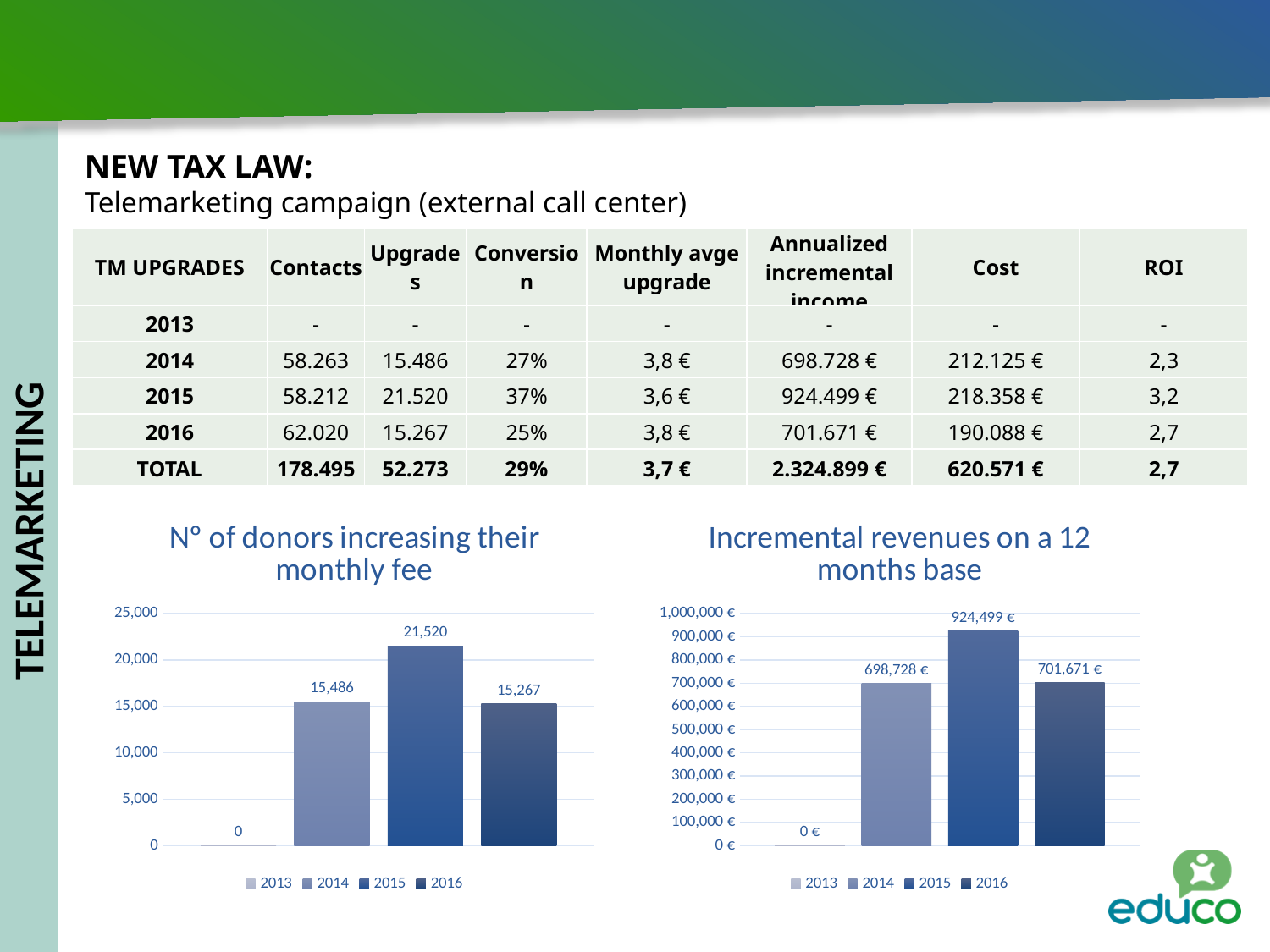
In the chart 'N° of donors increasing their monthly fee', what is the value for 2015? 21,520 In the chart 'N° of donors increasing their monthly fee', what is the difference between the 2015 and 2014 values? 6,034 In the chart 'Incremental revenues on a 12 months base', what is the difference between the 2016 and 2014 values? 2,943 € In the chart 'Incremental revenues on a 12 months base', what is the value for 2015? 924,499 € In the chart 'Incremental revenues on a 12 months base', what is the value for 2014? 698,728 € In the chart 'N° of donors increasing their monthly fee', is the value for 2014 greater or less than 15,000? greater In the chart 'N° of donors increasing their monthly fee', what is the value for 2016? 15,267 In the chart 'N° of donors increasing their monthly fee', which year has the highest value? 2015 In the chart 'Incremental revenues on a 12 months base', which is larger, the value for 2014 or the value for 2016? 2016 In the chart 'N° of donors increasing their monthly fee', how many years does the legend list? 4 In the chart 'Incremental revenues on a 12 months base', which year has the lowest value? 2013 What type of chart is 'Incremental revenues on a 12 months base'? bar chart